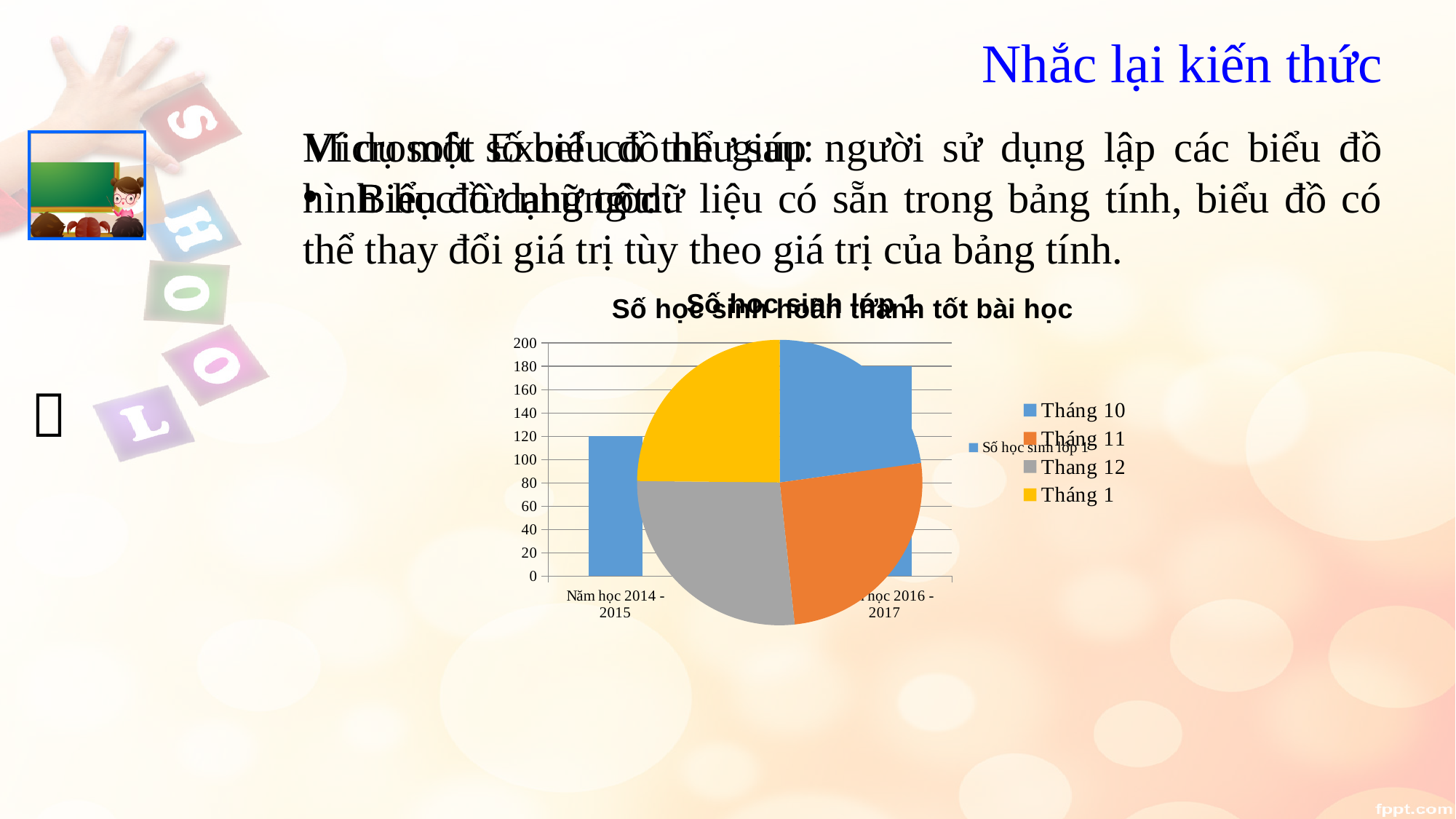
In the bar chart "Số học sinh lớp 1", what is the value for Năm học 2014 - 2015? 120 What is the legend entry of the bar chart on the slide? Số học sinh lớp 1 How many series does the legend of the bar chart "Số học sinh lớp 1" list? 1 In the bar chart "Số học sinh lớp 1", is the value for Năm học 2014 - 2015 greater or less than 140? less In the bar chart "Số học sinh lớp 1", what is the value for Năm học 2016 - 2017? 180 What kind of chart is the chart titled "Số học sinh hoàn thành tốt bài học"? pie chart What kind of chart is the chart titled "Số học sinh lớp 1"? bar chart How many entries does the legend of the pie chart "Số học sinh hoàn thành tốt bài học" list? 4 In the bar chart "Số học sinh lớp 1", is the value for Năm học 2016 - 2017 greater or less than 160? greater In the bar chart "Số học sinh lớp 1", what is the difference between the values for Năm học 2016 - 2017 and Năm học 2014 - 2015? 60 In the bar chart "Số học sinh lớp 1", which is larger: Năm học 2014 - 2015 or Năm học 2016 - 2017? Năm học 2016 - 2017 In the pie chart "Số học sinh hoàn thành tốt bài học", what colour is the slice for Tháng 1? yellow